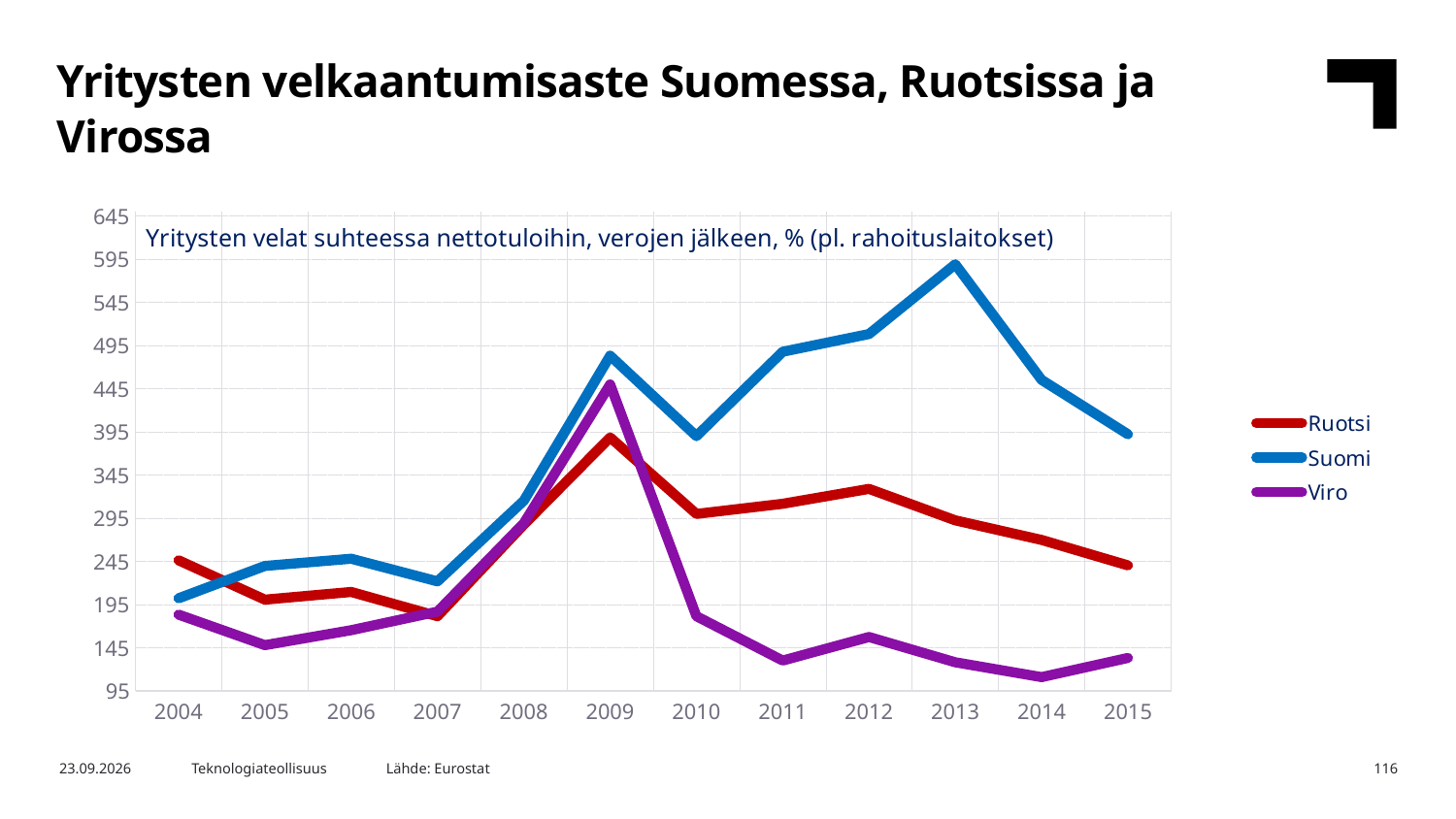
In which year does the Viro line reach its lowest value? 2014 Which is larger in 2004, the value for Ruotsi or the value for Suomi? Ruotsi How many years are shown on the x axis? 12 In which year does the Suomi line reach its highest value? 2013 Is the value for Ruotsi in 2009 greater or less than 345? greater Which series has the lowest value in 2015? Viro What kind of chart is shown on the slide? Line chart Does the Suomi line rise or fall from 2013 to 2015? Fall Which series has the highest value in 2013? Suomi Is the value for Viro in 2014 greater or less than 145? less Is the value for Suomi in 2013 greater or less than 545? greater How many series does the legend list? 3